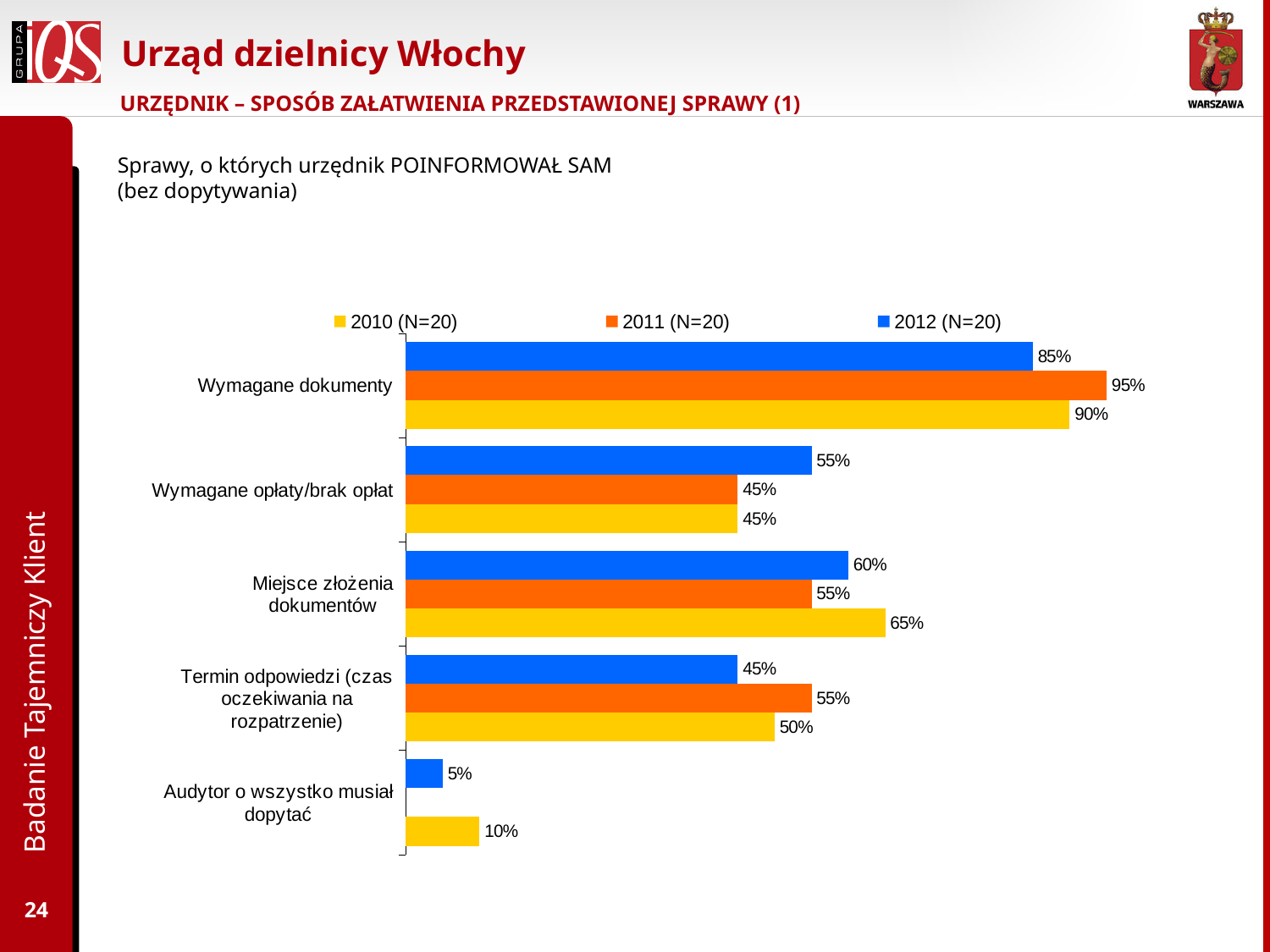
Which category has the highest value in the 2012 (N=20) series? Wymagane dokumenty How many series does the legend list? 3 What is the difference between the 2011 (N=20) and 2012 (N=20) values for 'Wymagane dokumenty'? 10% What is the value for 'Miejsce złożenia dokumentów' in the 2010 (N=20) series? 65% What is the value for 'Wymagane dokumenty' in the 2011 (N=20) series? 95% For 'Termin odpowiedzi (czas oczekiwania na rozpatrzenie)', which series has the larger value, 2011 (N=20) or 2012 (N=20)? 2011 (N=20) What is the value for 'Wymagane opłaty/brak opłat' in the 2012 (N=20) series? 55% What kind of chart is shown on the slide? bar chart What is the value for 'Audytor o wszystko musiał dopytać' in the 2012 (N=20) series? 5% Which category has the lowest value in the 2010 (N=20) series? Audytor o wszystko musiał dopytać Which colour represents the 2010 (N=20) series in the legend? yellow How many categories are shown on the chart? 5